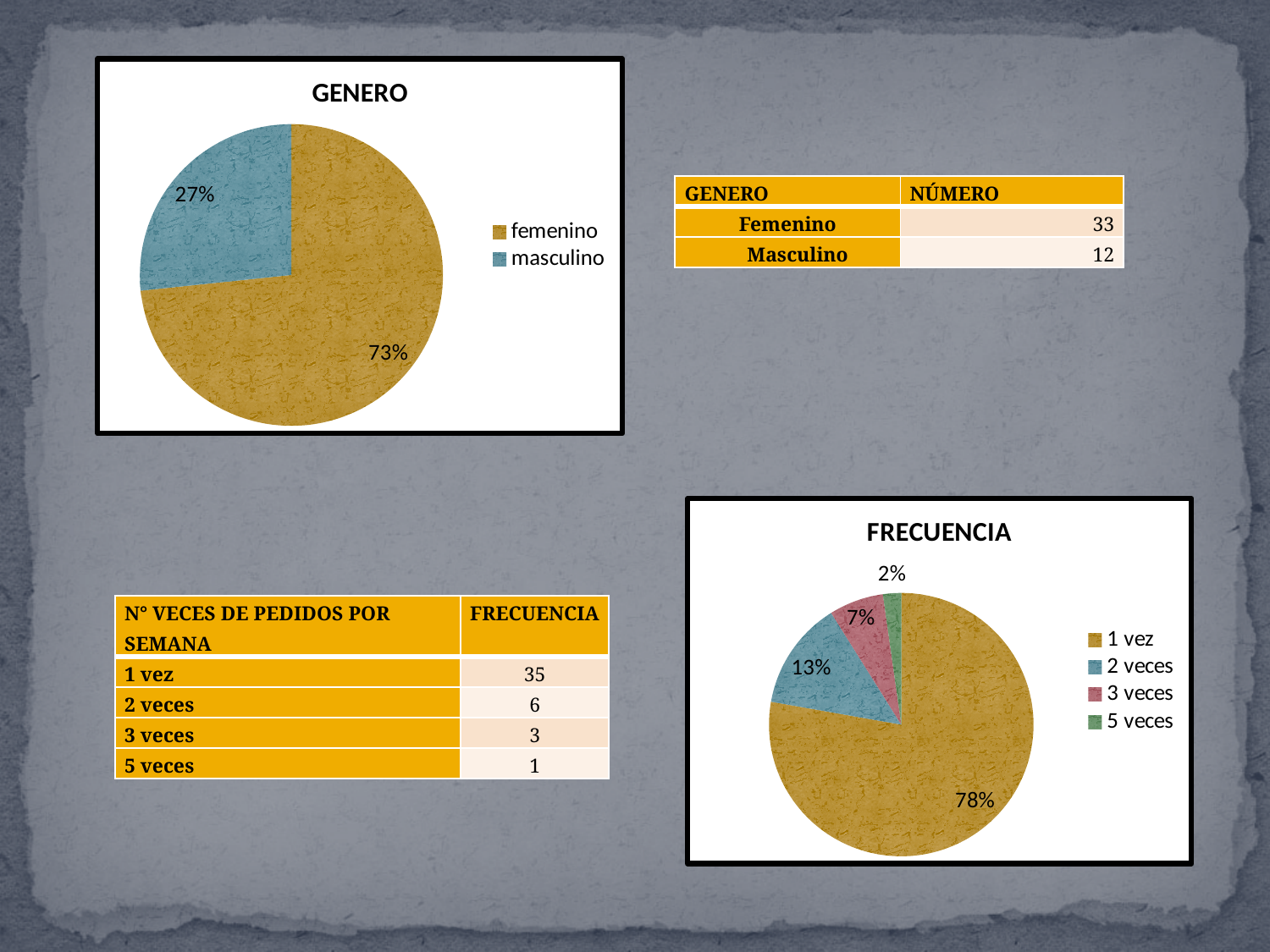
In the GENERO chart, what share of the pie is femenino? 73% In the FRECUENCIA chart, which category has the smallest slice? 5 veces In the FRECUENCIA chart, what share of the pie is 3 veces? 7% In the FRECUENCIA chart, what share of the pie is 2 veces? 13% How many categories does the GENERO chart show? 2 In the GENERO chart, which category has the largest slice? femenino How many entries does the legend of the FRECUENCIA chart list? 4 What kind of chart is the GENERO chart? pie chart In the GENERO chart, what is the difference in percentage points between femenino and masculino? 46 In the FRECUENCIA chart, which slice is larger, 2 veces or 3 veces? 2 veces